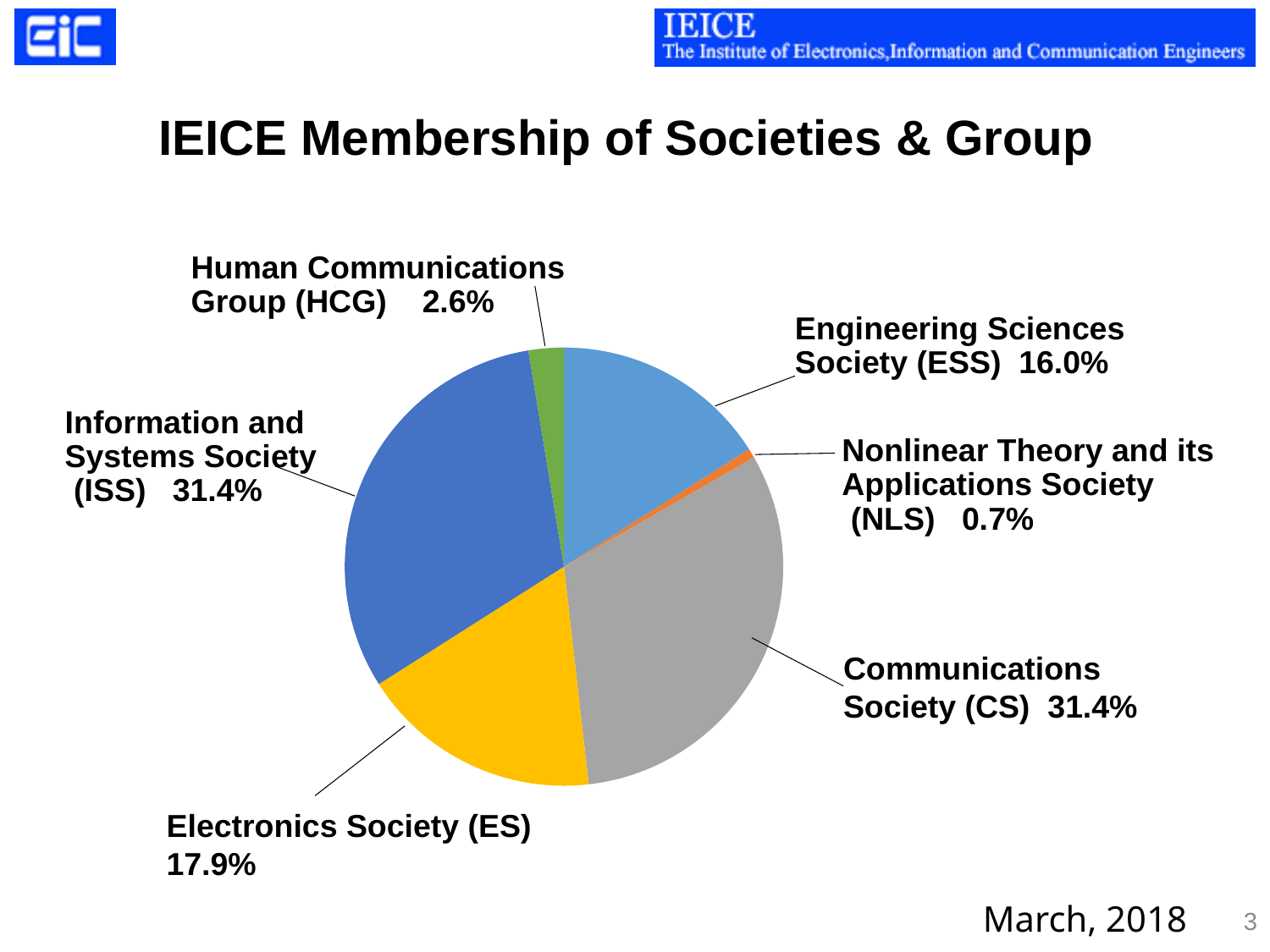
What share of IEICE membership does the Engineering Sciences Society (ESS) hold? 16.0% How many slices does the pie chart have? 6 Which is larger, the share of the Electronics Society (ES) or the Engineering Sciences Society (ESS)? Electronics Society (ES) What is the difference between the Electronics Society (ES) share and the Engineering Sciences Society (ESS) share? 1.9% What is the value for the Nonlinear Theory and its Applications Society (NLS)? 0.7% What percentage is shown for the Human Communications Group (HCG)? 2.6% What is the title of the chart on the slide? IEICE Membership of Societies & Group What is the combined share of the Information and Systems Society (ISS) and the Communications Society (CS)? 62.8% What kind of chart is shown on the slide? pie chart What is the value shown for the Electronics Society (ES)? 17.9% Which society or group has the smallest share of the pie? Nonlinear Theory and its Applications Society (NLS) What is the difference between the Communications Society (CS) share and the Human Communications Group (HCG) share? 28.8%